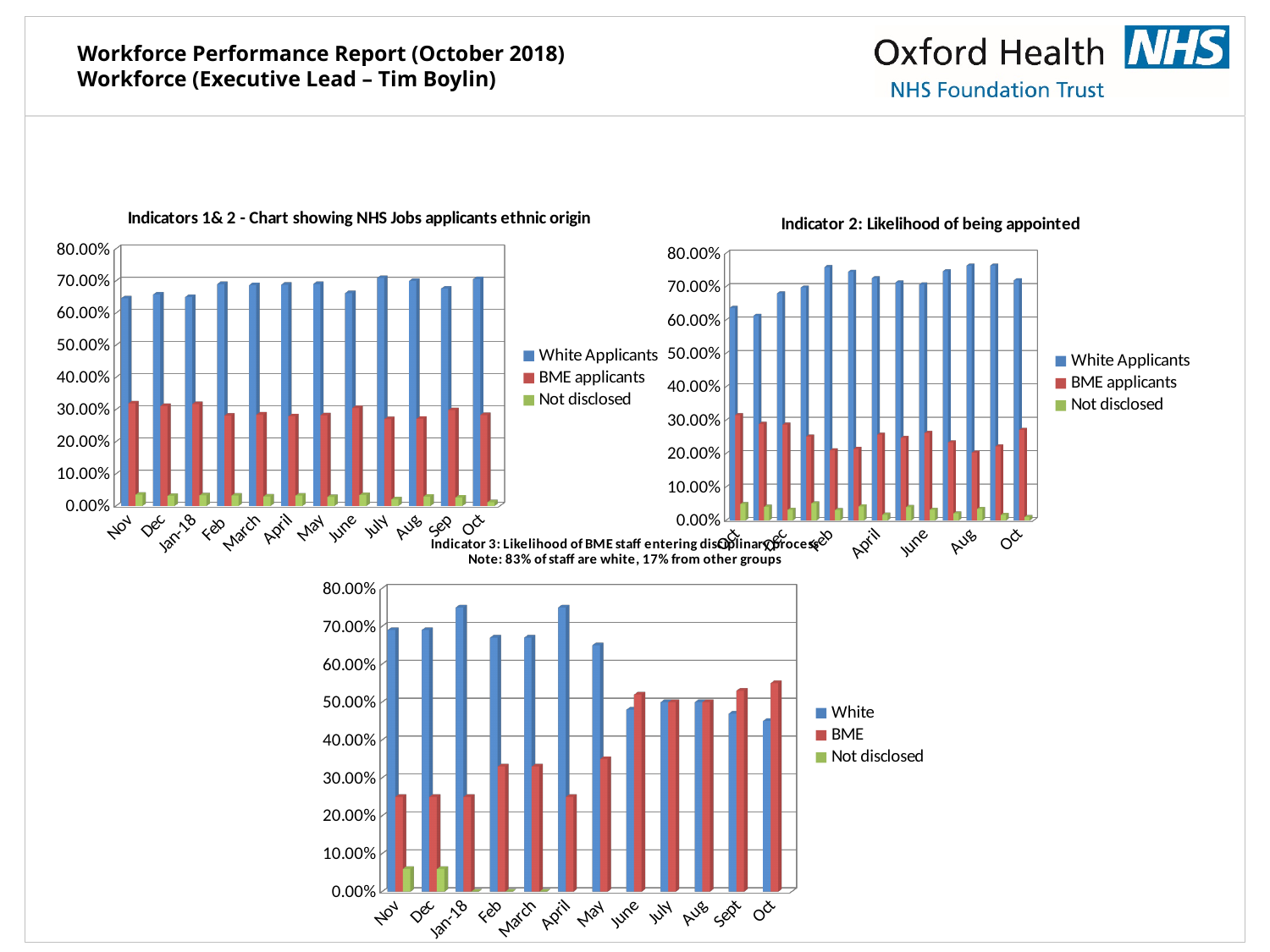
In the chart 'Indicators 1& 2 - Chart showing NHS Jobs applicants ethnic origin', how many months are shown on the x axis? 12 In the chart 'Indicators 1& 2 - Chart showing NHS Jobs applicants ethnic origin', is the value for Not disclosed in Nov greater or less than 10.00%? less What kind of chart is 'Indicators 1& 2 - Chart showing NHS Jobs applicants ethnic origin'? bar chart In the chart 'Indicator 3: Likelihood of BME staff entering disciplinary process', is the value for White in April greater or less than 70.00%? greater In the chart 'Indicator 2: Likelihood of being appointed', is the value for White Applicants in Feb greater or less than 70.00%? greater What are the legend entries of the chart 'Indicator 3: Likelihood of BME staff entering disciplinary process'? White, BME, Not disclosed In the chart 'Indicator 3: Likelihood of BME staff entering disciplinary process', which is larger in Oct: White or BME? BME How many series does the legend of 'Indicator 2: Likelihood of being appointed' list? 3 In the chart 'Indicators 1& 2 - Chart showing NHS Jobs applicants ethnic origin', which is larger in Nov: White Applicants or BME applicants? White Applicants How many series does the legend of 'Indicators 1& 2 - Chart showing NHS Jobs applicants ethnic origin' list? 3